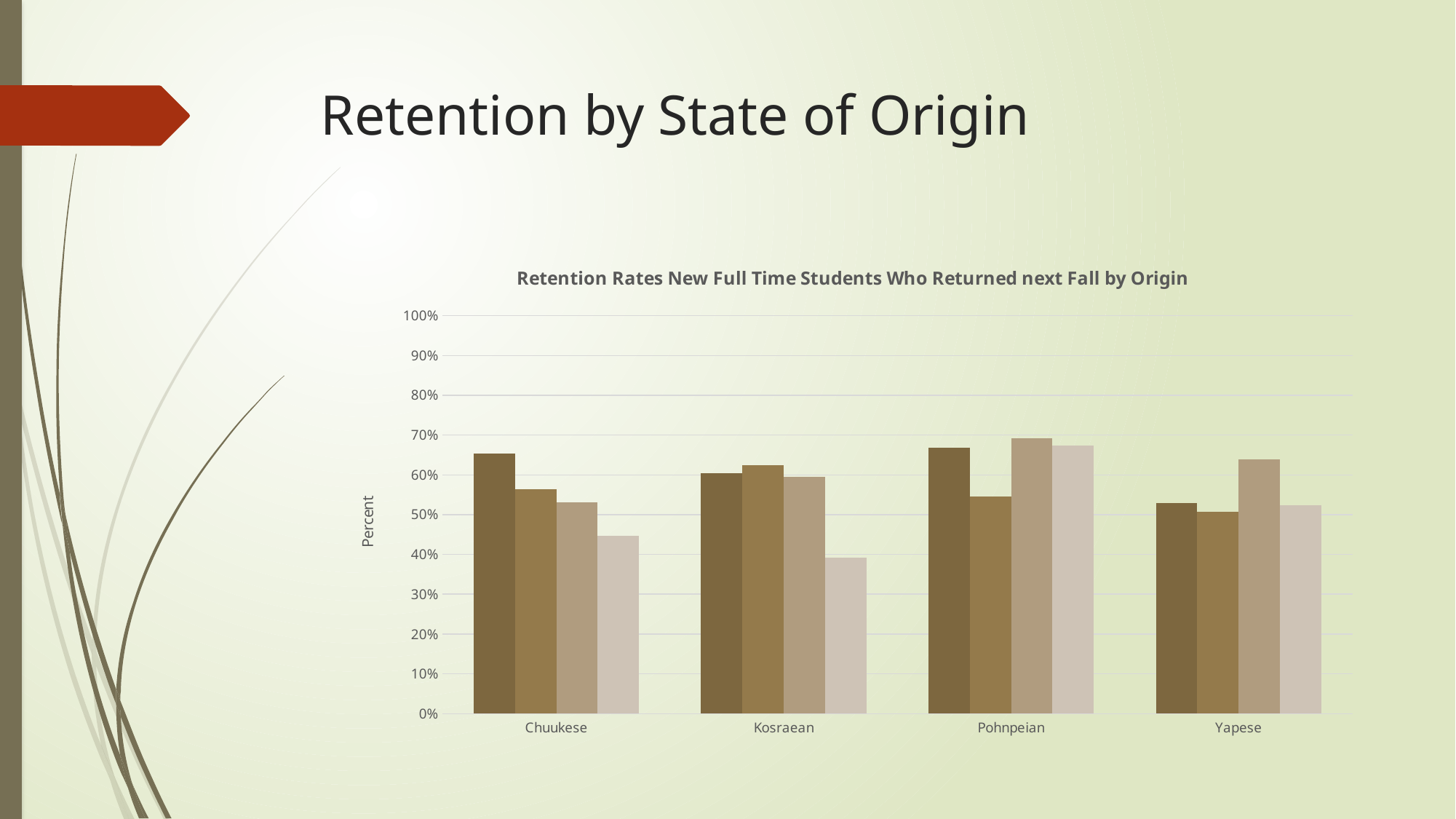
Which origin category contains the single tallest bar in the chart? Pohnpeian How many origin categories are shown on the x axis of the chart? 4 Is the value of the lightest (rightmost) bar for Chuukese greater or less than 50%? less What is the title of the chart? Retention Rates New Full Time Students Who Returned next Fall by Origin Is the value of the darkest (leftmost) bar for Chuukese greater or less than 60%? greater What is the label on the vertical axis of the chart? Percent What kind of chart is shown on the slide? bar chart How many bars are plotted for each origin category? 4 Is the value of the lightest (rightmost) bar for Kosraean greater or less than 50%? less Which is larger: the darkest (leftmost) bar for Chuukese or the darkest (leftmost) bar for Yapese? Chuukese